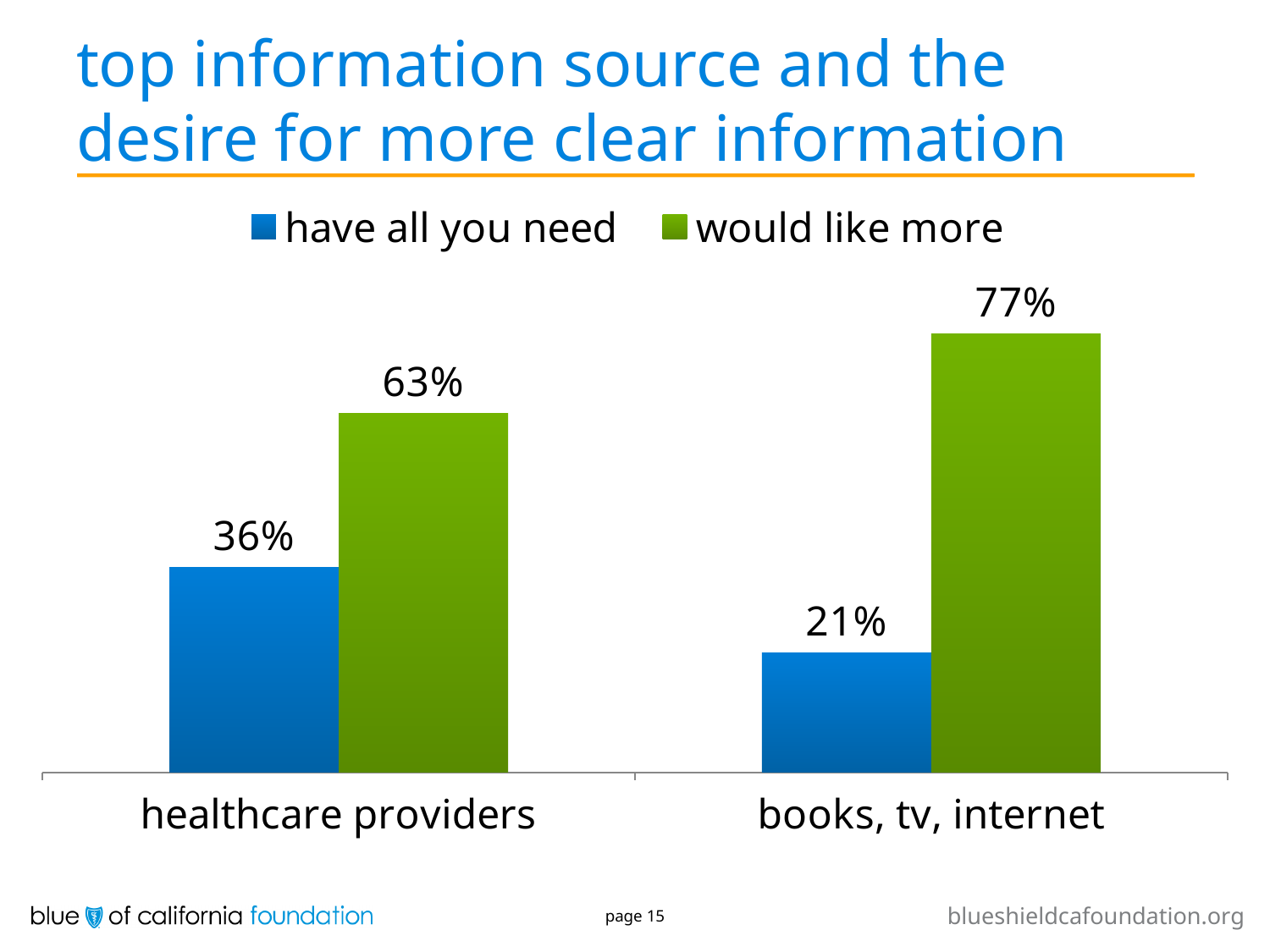
How much higher is the 'would like more' value for books, tv, internet than for healthcare providers? 14% Is the 'have all you need' value larger for healthcare providers or for books, tv, internet? healthcare providers How many series does the legend list? 2 Which category has the lowest 'have all you need' value? books, tv, internet What is the 'have all you need' value for books, tv, internet? 21% How many categories are shown on the x axis? 2 Which category has the highest 'would like more' value? books, tv, internet What is the difference between the 'would like more' and 'have all you need' values for healthcare providers? 27% What percentage of respondents who use healthcare providers as their top information source say they have all the information they need? 36% What kind of chart is shown on the slide? bar chart What is the 'would like more' value for the books, tv, internet category? 77% What is the 'would like more' value for healthcare providers? 63%